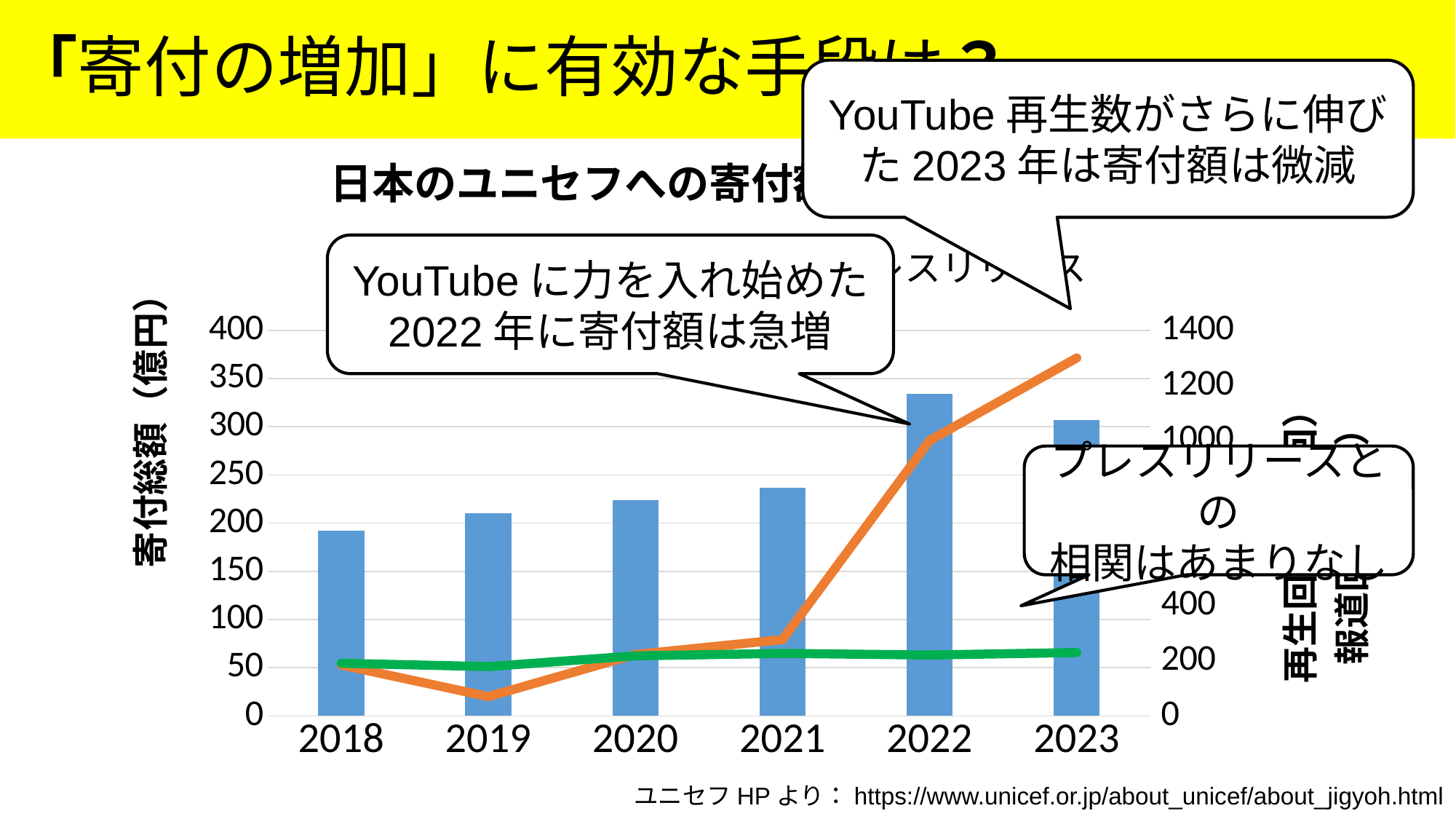
Do the bar values rise or fall from 2018 to 2022? rise Which bar is taller, 2022 or 2023? 2022 In which year does the orange line reach its highest point? 2023 Is the bar value for 2021 greater or less than 250 on the left axis? less Which bar is taller, 2018 or 2019? 2019 Which year has the shortest bar (lowest donation total) in the chart? 2018 In which year does the orange line reach its lowest point? 2019 Is the bar value for 2022 greater or less than 300 on the left axis? greater Is the orange line value for 2023 greater or less than 1200 on the right axis? greater How many years are shown on the x axis of the chart? 6 Which year has the tallest bar (highest donation total) in the chart? 2022